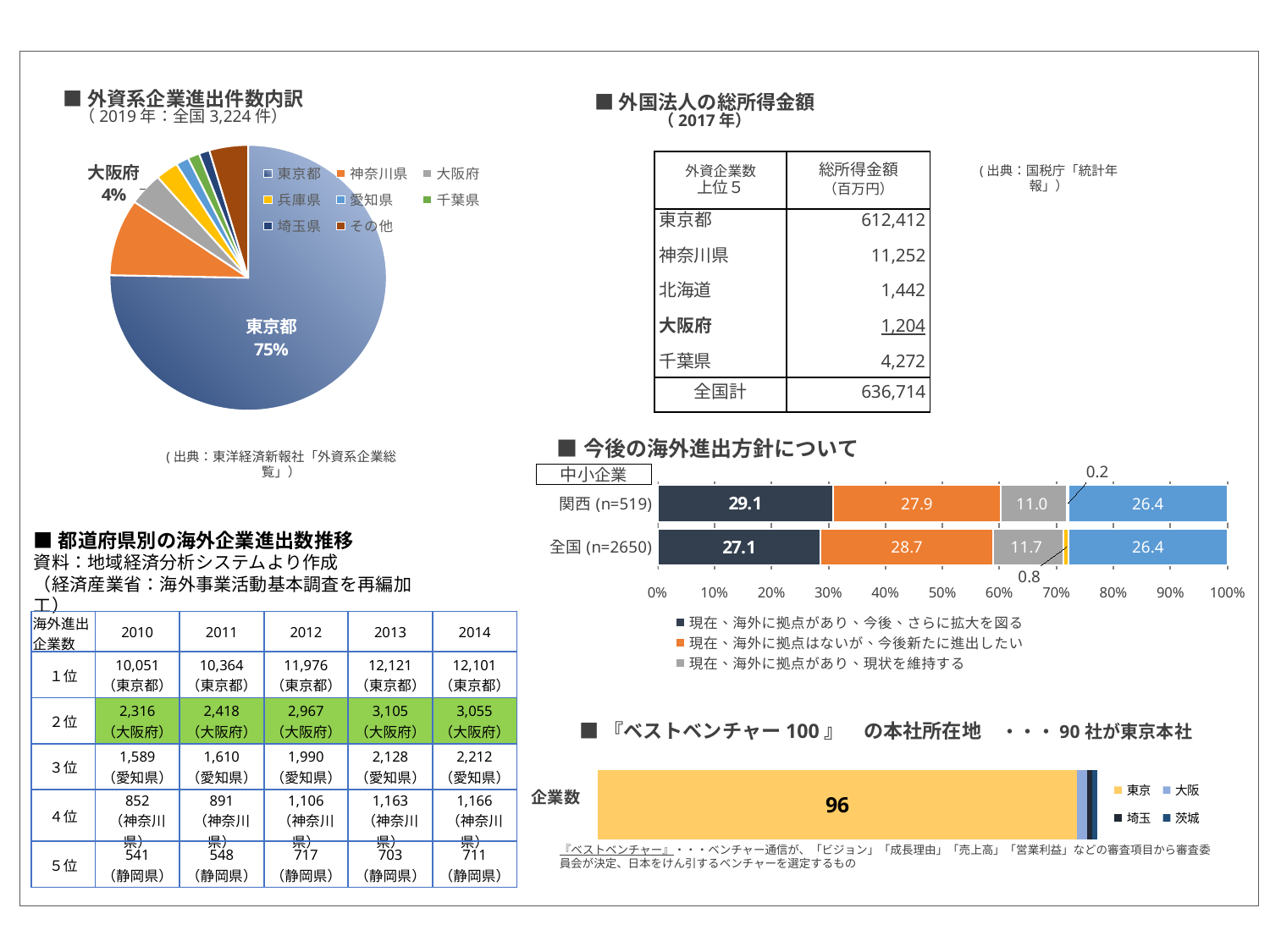
In the chart 今後の海外進出方針について, what is the value of the first (dark blue) segment for 関西 (n=519)? 29.1 What kind of chart is 外資系企業進出件数内訳? pie chart What kind of chart is 今後の海外進出方針について? stacked bar chart In the chart 今後の海外進出方針について, what is the value of the grey segment for 関西 (n=519)? 11.0 In the chart 今後の海外進出方針について, what is the difference between the grey segment values for 全国 (n=2650) and 関西 (n=519)? 0.7 In the chart 今後の海外進出方針について, what is the value of the orange segment for 全国 (n=2650)? 28.7 In the chart 今後の海外進出方針について, which is larger: the dark blue segment for 関西 (n=519) or for 全国 (n=2650)? 関西 (n=519) In the pie chart 外資系企業進出件数内訳, which category has the largest slice? 東京都 In the pie chart 外資系企業進出件数内訳, what share does 東京都 hold? 75% How many entries does the legend of the pie chart 外資系企業進出件数内訳 list? 8 In the pie chart 外資系企業進出件数内訳, what share does 大阪府 hold? 4% In the chart ベストベンチャー100 の本社所在地, what is the value shown for 東京? 96